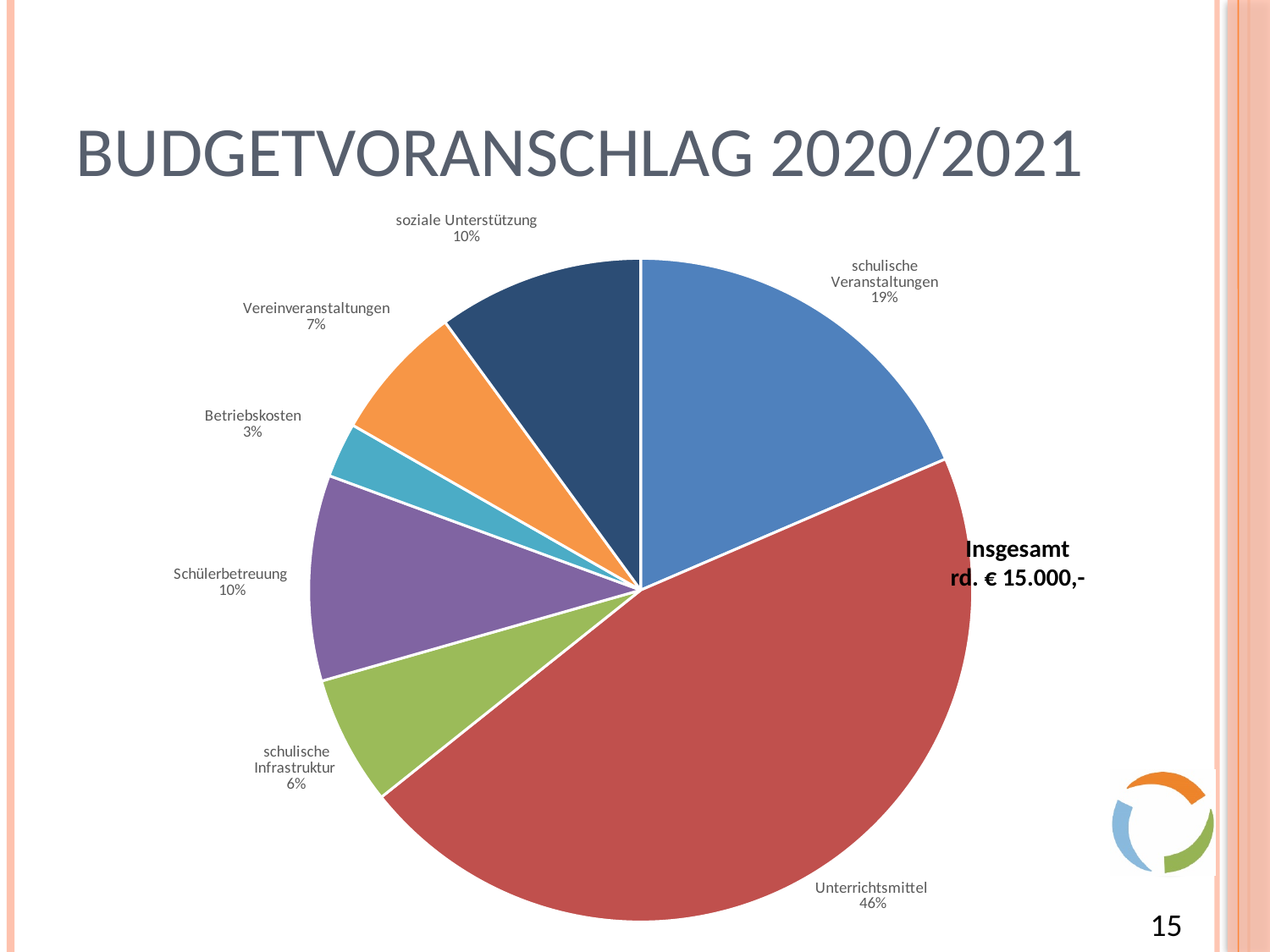
How many categories does the pie chart show? 7 What kind of chart is shown on the slide? pie chart What total budget amount is stated next to the pie chart? rd. € 15.000,- Which category has the smallest share of the budget? Betriebskosten What percentage is shown for Betriebskosten? 3% What share of the budget goes to schulische Veranstaltungen? 19% Which is larger, the share for Schülerbetreuung or the share for Vereinveranstaltungen? Schülerbetreuung What is the difference in percentage points between Unterrichtsmittel and schulische Veranstaltungen? 27 What percentage is shown for schulische Infrastruktur? 6% Which category has the largest share of the budget? Unterrichtsmittel What share of the budget goes to Unterrichtsmittel? 46% What percentage is shown for Vereinveranstaltungen? 7%